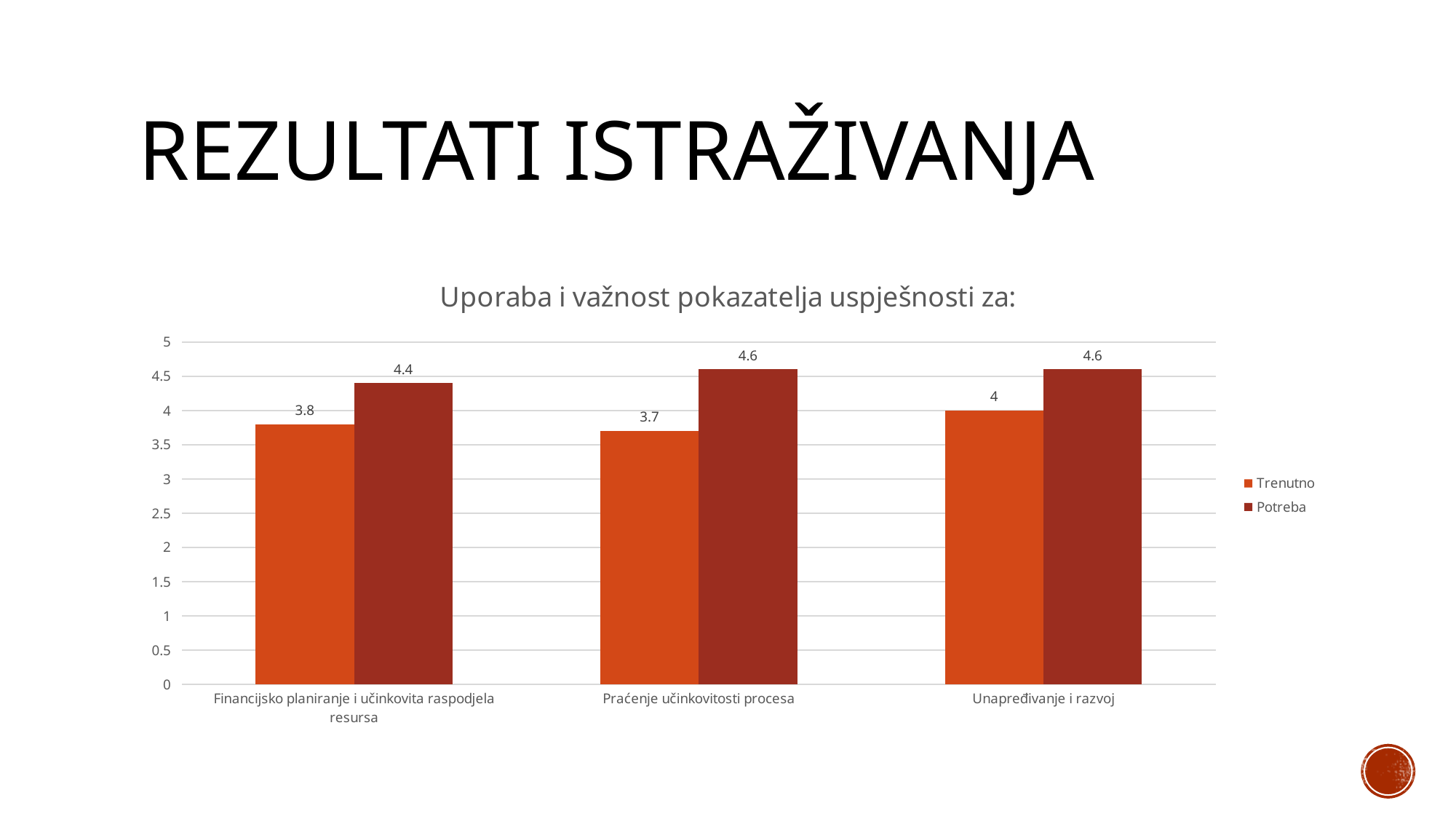
What is the Trenutno value for Unapređivanje i razvoj? 4 What is the Potreba value for Praćenje učinkovitosti procesa? 4.6 What is the Trenutno value for Financijsko planiranje i učinkovita raspodjela resursa? 3.8 Which category has the lowest Trenutno value? Praćenje učinkovitosti procesa What is the difference between the Potreba and Trenutno values for Praćenje učinkovitosti procesa? 0.9 What is the difference between the Potreba and Trenutno values for Unapređivanje i razvoj? 0.6 How many series does the legend list? 2 What is the Potreba value for Financijsko planiranje i učinkovita raspodjela resursa? 4.4 Which is larger for Financijsko planiranje i učinkovita raspodjela resursa: Trenutno or Potreba? Potreba How many categories are shown on the x axis? 3 What type of chart is shown on the slide? Bar chart Which category has the lowest Potreba value? Financijsko planiranje i učinkovita raspodjela resursa